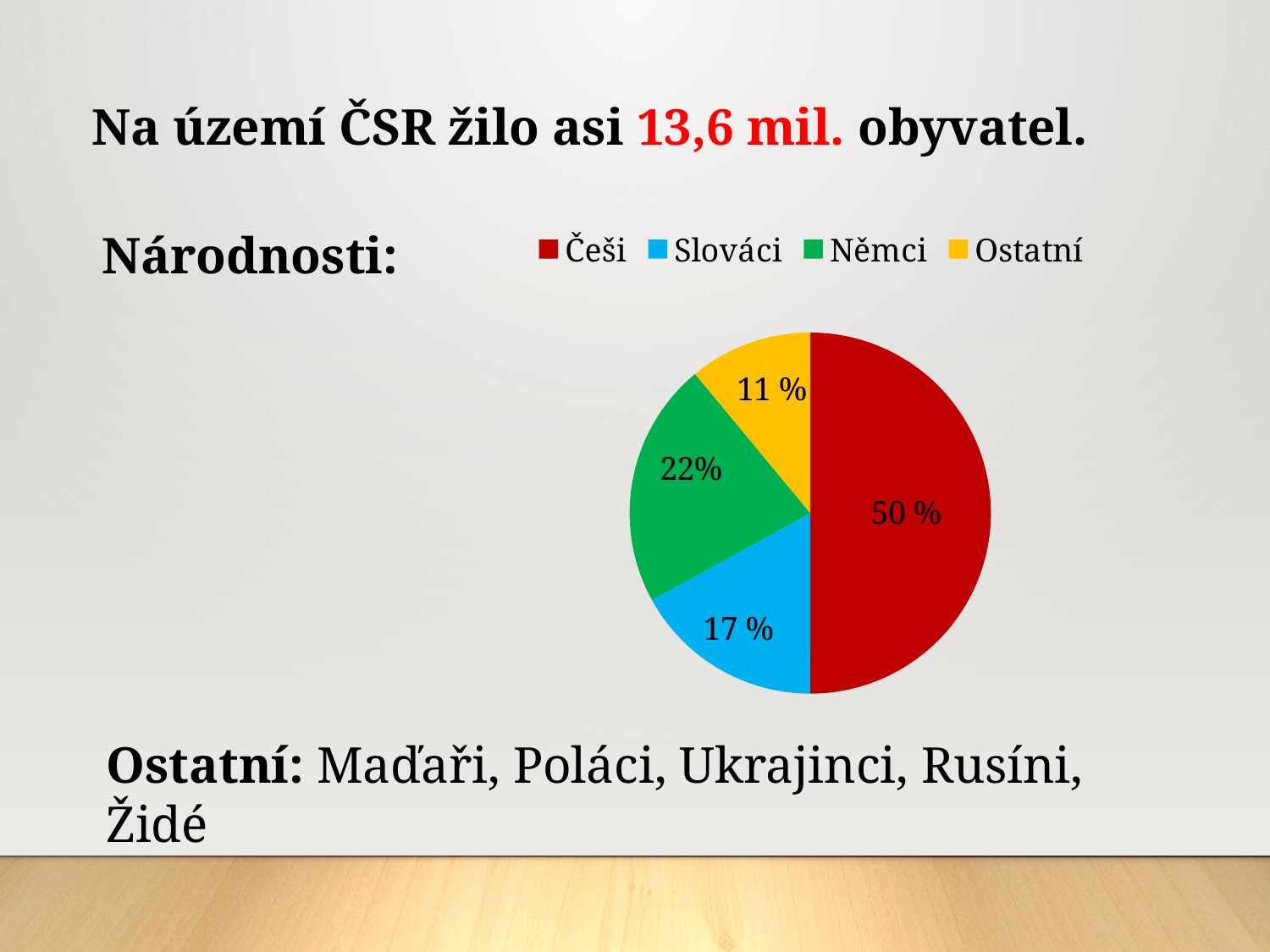
What is the difference in percentage points between the Češi slice and the Němci slice? 28 What is the difference in percentage points between the Slováci slice and the Ostatní slice? 6 What share of the pie does Češi have? 50 % What share of the pie does Ostatní have? 11 % What share of the pie does Slováci have? 17 % What kind of chart is shown on the slide? Pie chart What colour is the Slováci slice in the pie chart? Blue How many slices does the pie chart have? 4 Which nationality has the largest slice of the pie? Češi Which slice is larger, Němci or Slováci? Němci Which nationality has the smallest slice of the pie? Ostatní What share of the pie does Němci have? 22%